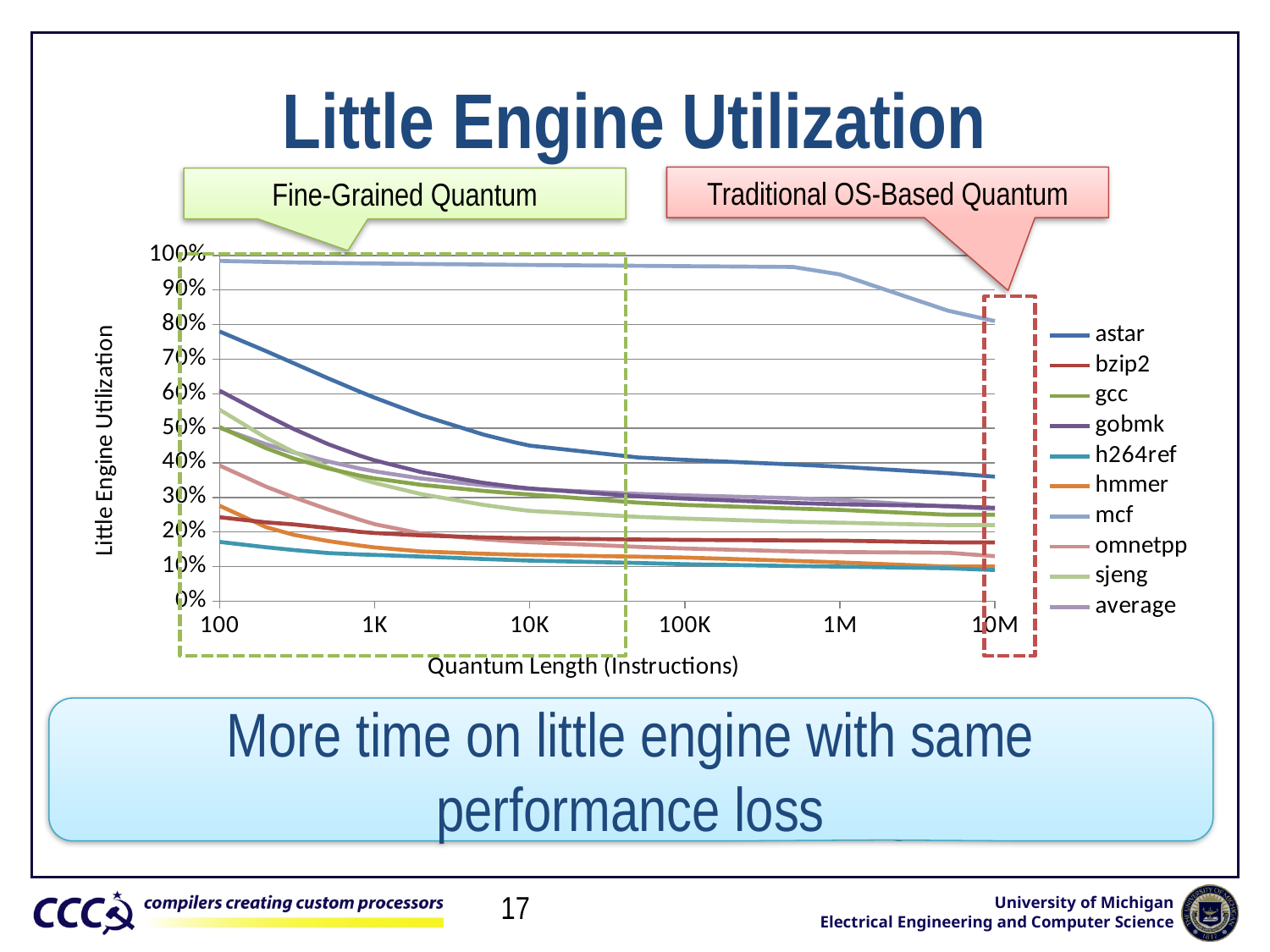
Which series has the highest Little Engine Utilization at a quantum length of 100? mcf What is the title of the x axis? Quantum Length (Instructions) Which series has the lowest Little Engine Utilization at a quantum length of 100? h264ref How many series does the legend list? 10 What is the title of the y axis? Little Engine Utilization Is the value for h264ref at a quantum length of 10M greater or less than 20%? less Is the value for astar at a quantum length of 100 greater or less than 70%? greater At a quantum length of 100, which is larger: the value for astar or the value for gobmk? astar How many tick labels are shown on the x axis (Quantum Length)? 6 Do the values for astar rise or fall as quantum length increases along the x axis? fall Is the value for mcf at a quantum length of 100 greater or less than 90%? greater What kind of chart is shown on the slide? line chart